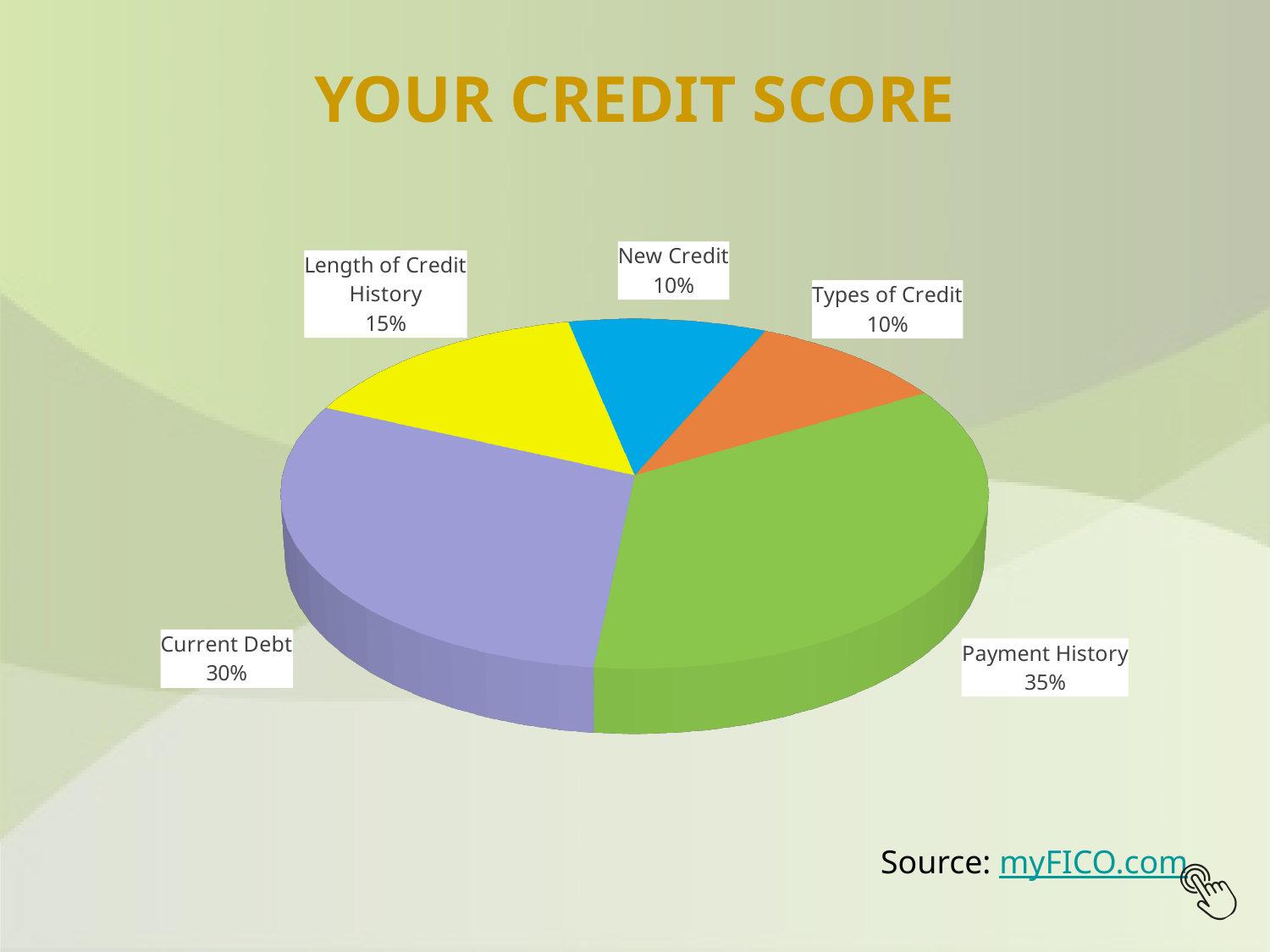
How many categories are shown in the pie chart? 5 What share of the credit score does New Credit account for? 10% What share of the credit score does Current Debt account for? 30% What share of the credit score does Payment History account for? 35% Which is larger, the share for Current Debt or the share for Length of Credit History? Current Debt What colour is the Payment History slice of the pie chart? green What kind of chart is shown on the slide? pie chart Which category has the largest share of the credit score? Payment History What is the difference between the shares of Payment History and Current Debt? 5% What is the title of the slide containing the pie chart? YOUR CREDIT SCORE What share of the credit score does Length of Credit History account for? 15% What is the difference between the shares of Length of Credit History and Types of Credit? 5%